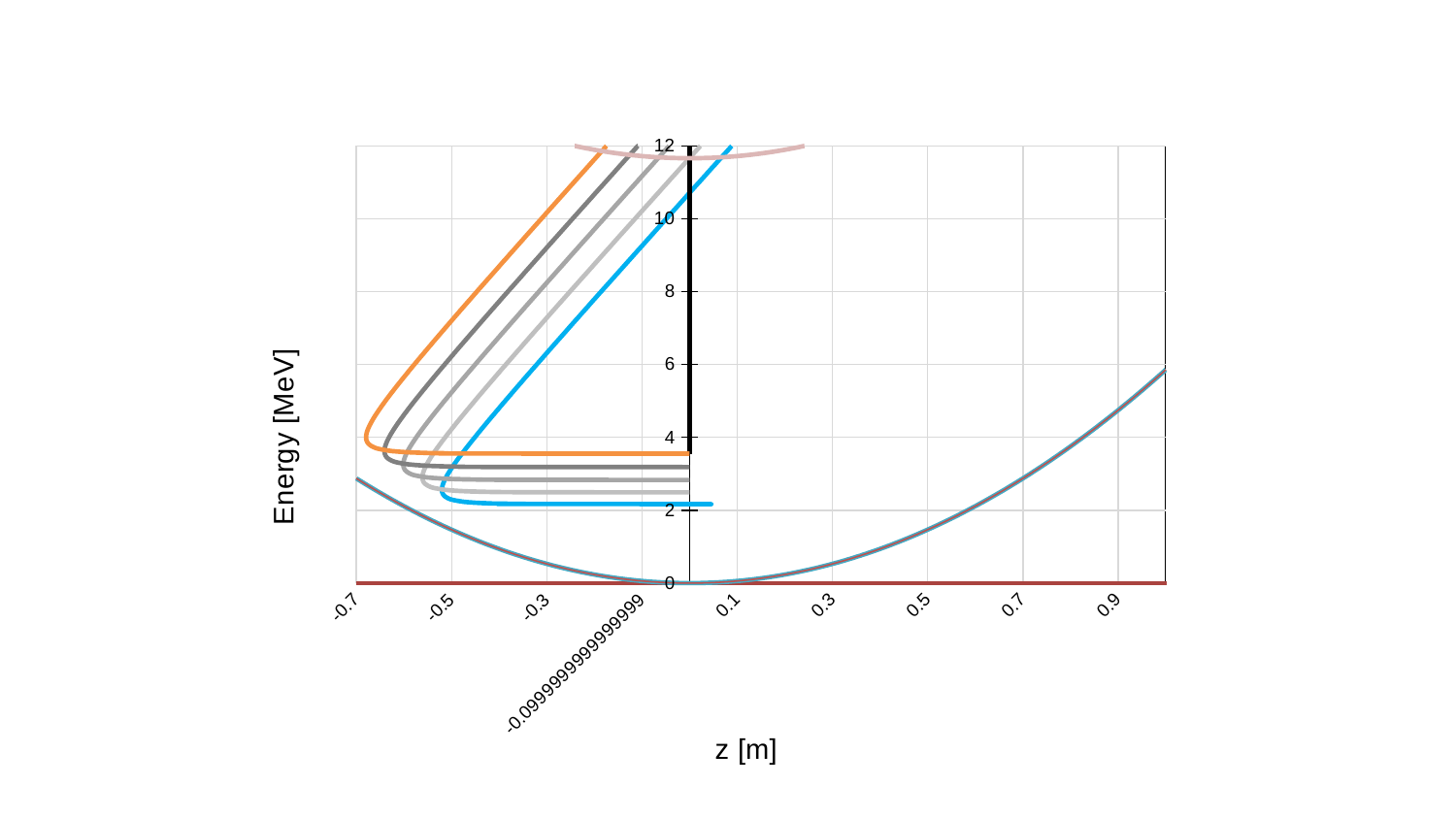
Is the horizontal part of the orange curve greater or less than 2 MeV? greater Is the value of the parabola-shaped curve at z = -0.7 greater or less than 4? less What is the label of the horizontal axis? z [m] Is the pink curve near the top of the chart greater or less than 10 MeV? greater What kind of chart is shown on the slide? line chart Which is larger: the horizontal part of the orange curve or the horizontal part of the blue curve? orange Does the parabola-shaped curve rise or fall as z increases from 0.1 to 0.9? rise Does the parabola-shaped curve rise or fall as z increases from -0.7 to 0? fall What is the label of the vertical axis? Energy [MeV]